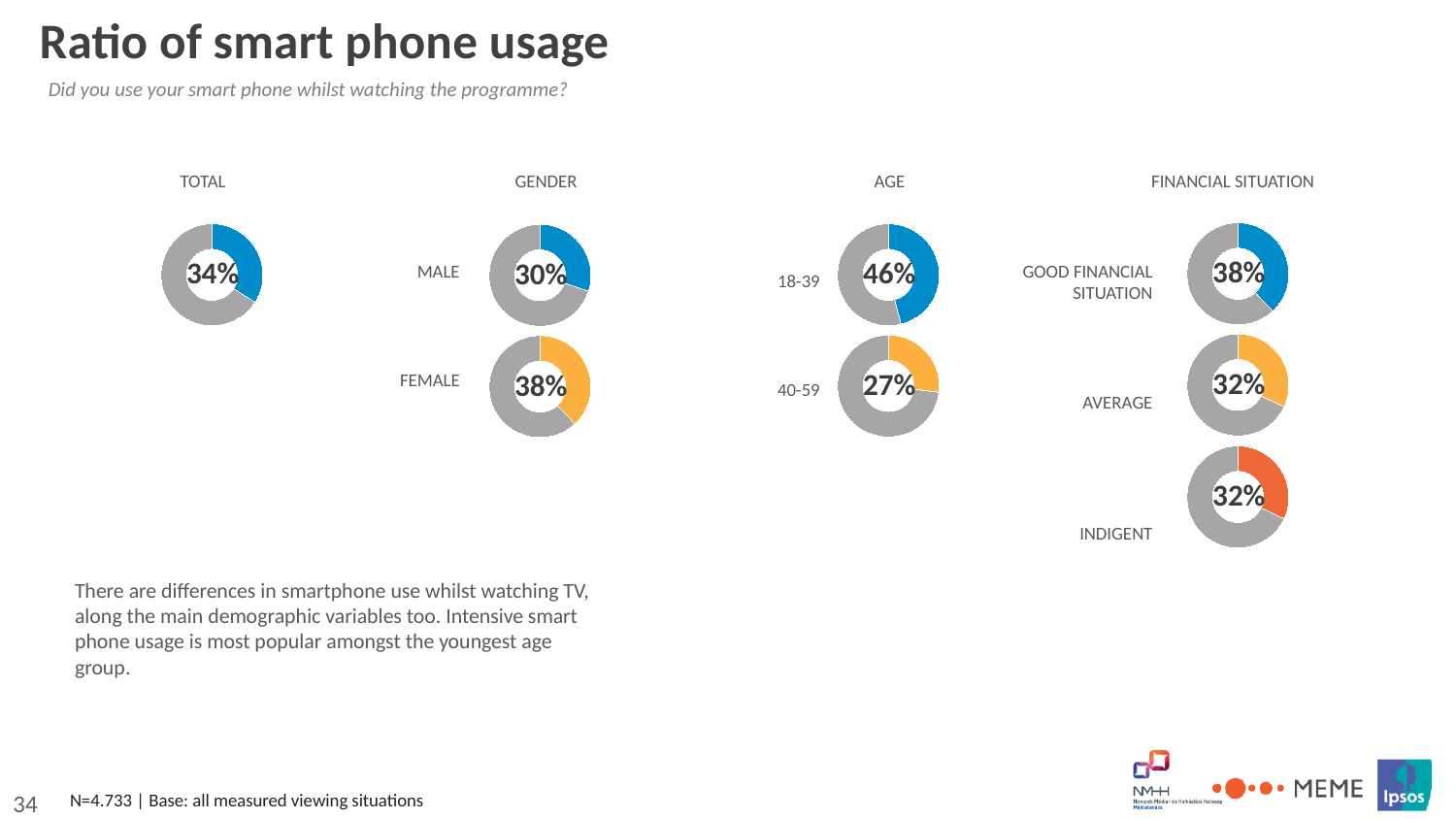
In the GENDER charts, what is the value shown for MALE? 30% In the GENDER charts, what is the value shown for FEMALE? 38% In the GENDER charts, which group has the higher value, MALE or FEMALE? FEMALE How many donut charts are shown under the FINANCIAL SITUATION heading? 3 In the AGE charts, what is the value shown for the 18-39 group? 46% In the FINANCIAL SITUATION charts, which category has the highest value? GOOD FINANCIAL SITUATION In the AGE charts, what is the difference between the 18-39 and 40-59 values? 19% In the TOTAL chart, what percentage of viewers used their smart phone whilst watching the programme? 34% What kind of chart is used to show the TOTAL value on the slide? Donut (pie) chart In the GENDER charts, what is the difference between the FEMALE and MALE values? 8% In the FINANCIAL SITUATION charts, what is the value shown for GOOD FINANCIAL SITUATION? 38% In the AGE charts, what is the value shown for the 40-59 group? 27%